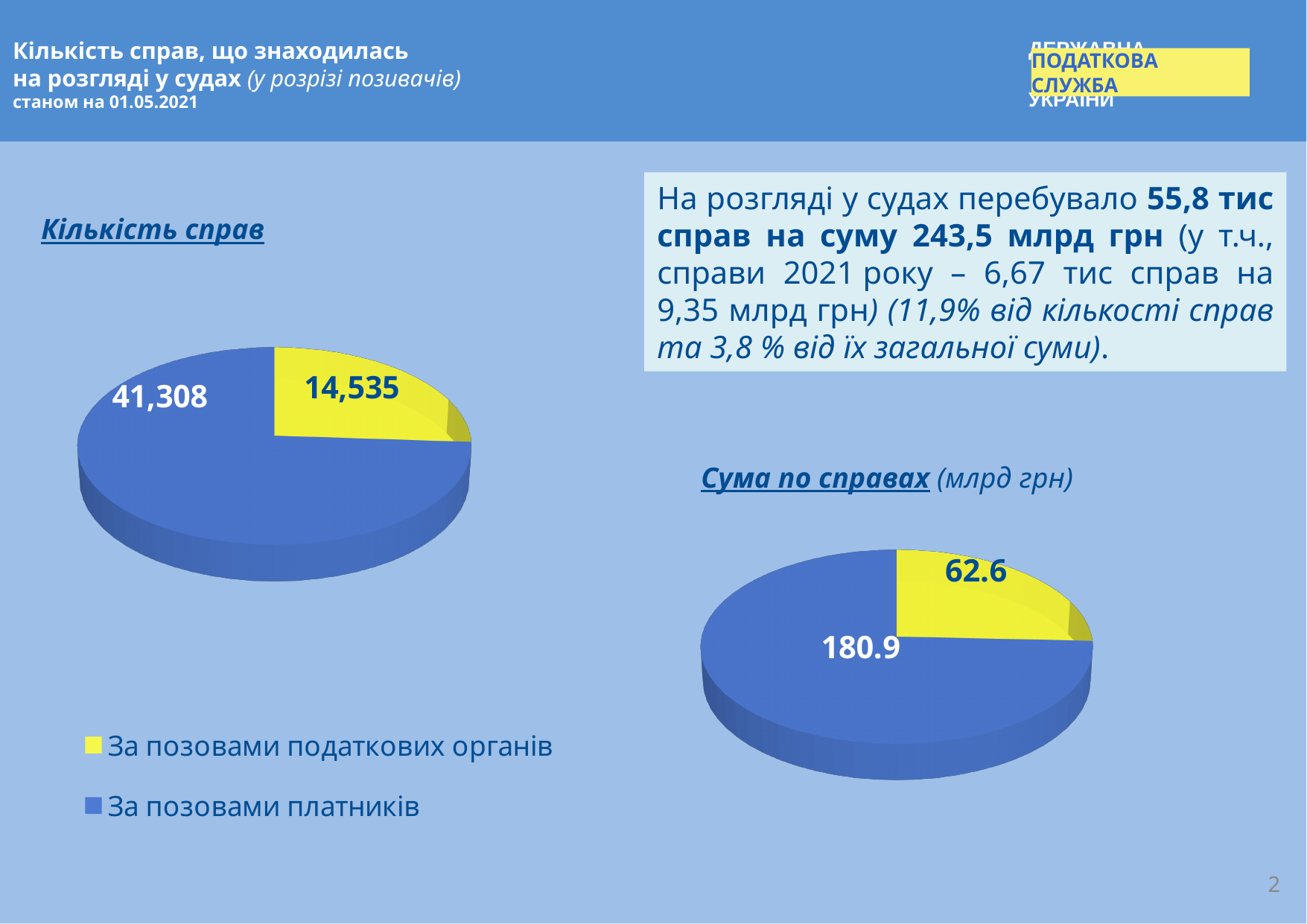
In the "Сума по справах" chart, which category has the smallest slice? За позовами податкових органів Which colour represents "За позовами податкових органів" in the legend? yellow In the "Сума по справах" chart, what is the value for "За позовами платників"? 180.9 In the "Сума по справах" chart, what is the total of the two slices? 243.5 In the "Кількість справ" chart, which category has the largest slice? За позовами платників In the "Сума по справах" chart, what is the difference between the values for "За позовами платників" and "За позовами податкових органів"? 118.3 How many slices does the "Кількість справ" pie chart have? 2 In the "Кількість справ" chart, what is the value for "За позовами податкових органів"? 14,535 In the "Кількість справ" chart, what is the value for "За позовами платників"? 41,308 In the "Сума по справах" chart, what is the value for "За позовами податкових органів"? 62.6 What type of chart is the "Кількість справ" chart? pie chart In the "Кількість справ" chart, what is the difference between the values for "За позовами платників" and "За позовами податкових органів"? 26,773